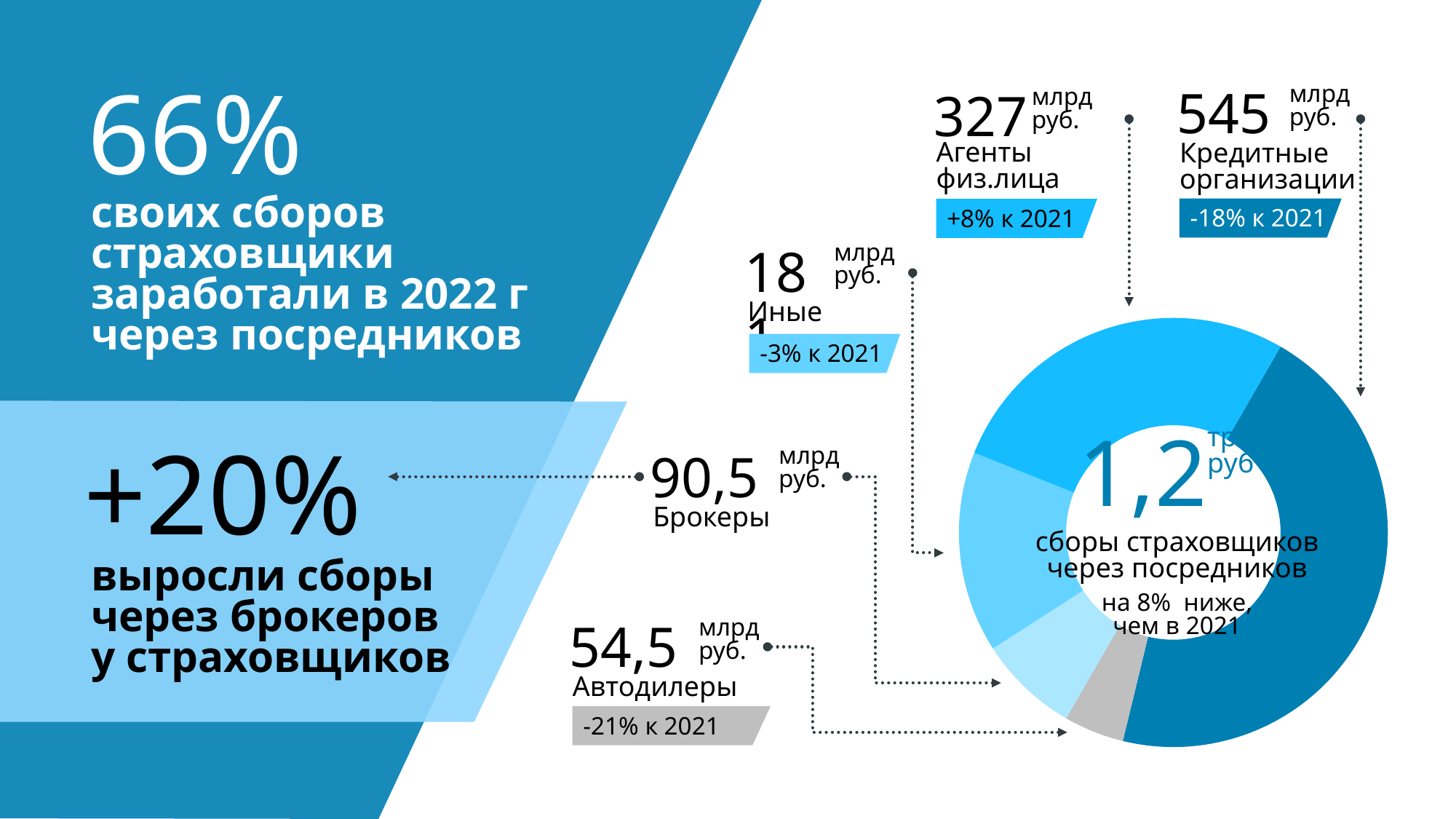
What kind of chart is shown on the slide? Pie (donut) chart What is the value for Брокеры? 90,5 млрд руб. Which category has the lowest value? Автодилеры What is the value for Автодилеры? 54,5 млрд руб. Which category has the highest value? Кредитные организации What is the difference between Брокеры and Автодилеры? 36 млрд руб. Which is larger, Брокеры or Автодилеры? Брокеры What is the value for Кредитные организации? 545 млрд руб. How many categories does the chart show? 5 What is the difference between Кредитные организации and Агенты физ.лица? 218 млрд руб. What is the value for Иные? 181 млрд руб. What is the value for Агенты физ.лица? 327 млрд руб.